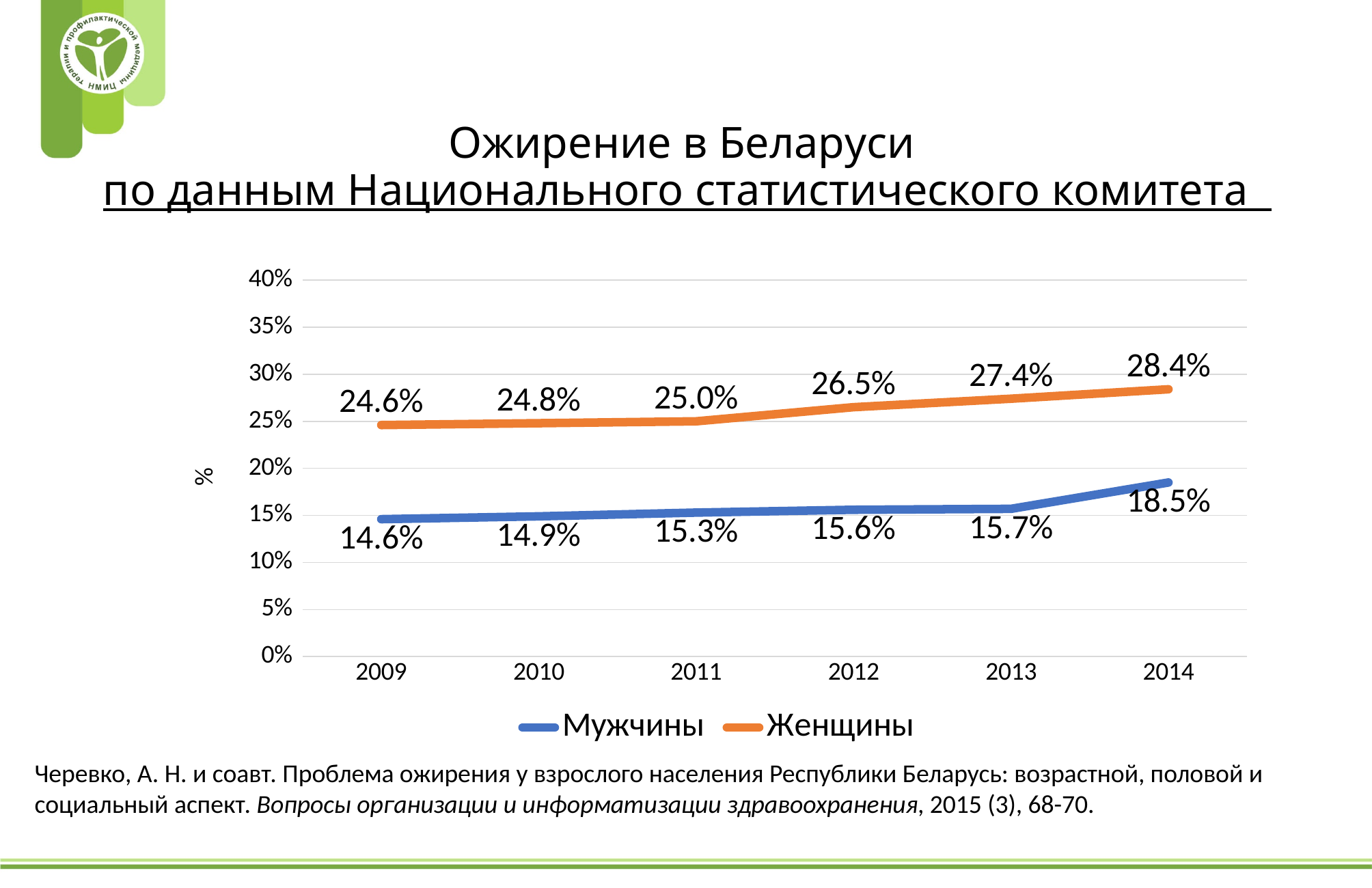
What is the value for Женщины in 2014? 28.4% Do the values for Мужчины rise or fall from 2009 to 2014? rise What is the value for Мужчины in 2012? 15.6% What kind of chart is shown on the slide? line chart Is the value for Женщины in 2013 greater or less than 25%? greater What is the value for Мужчины in 2009? 14.6% Which series has the larger value in 2011, Мужчины or Женщины? Женщины In which year is the value for Женщины highest? 2014 How many series does the legend list? 2 How many years are shown on the x axis? 6 In which year is the value for Мужчины lowest? 2009 What is the difference between the Женщины and Мужчины values in 2014? 9.9%